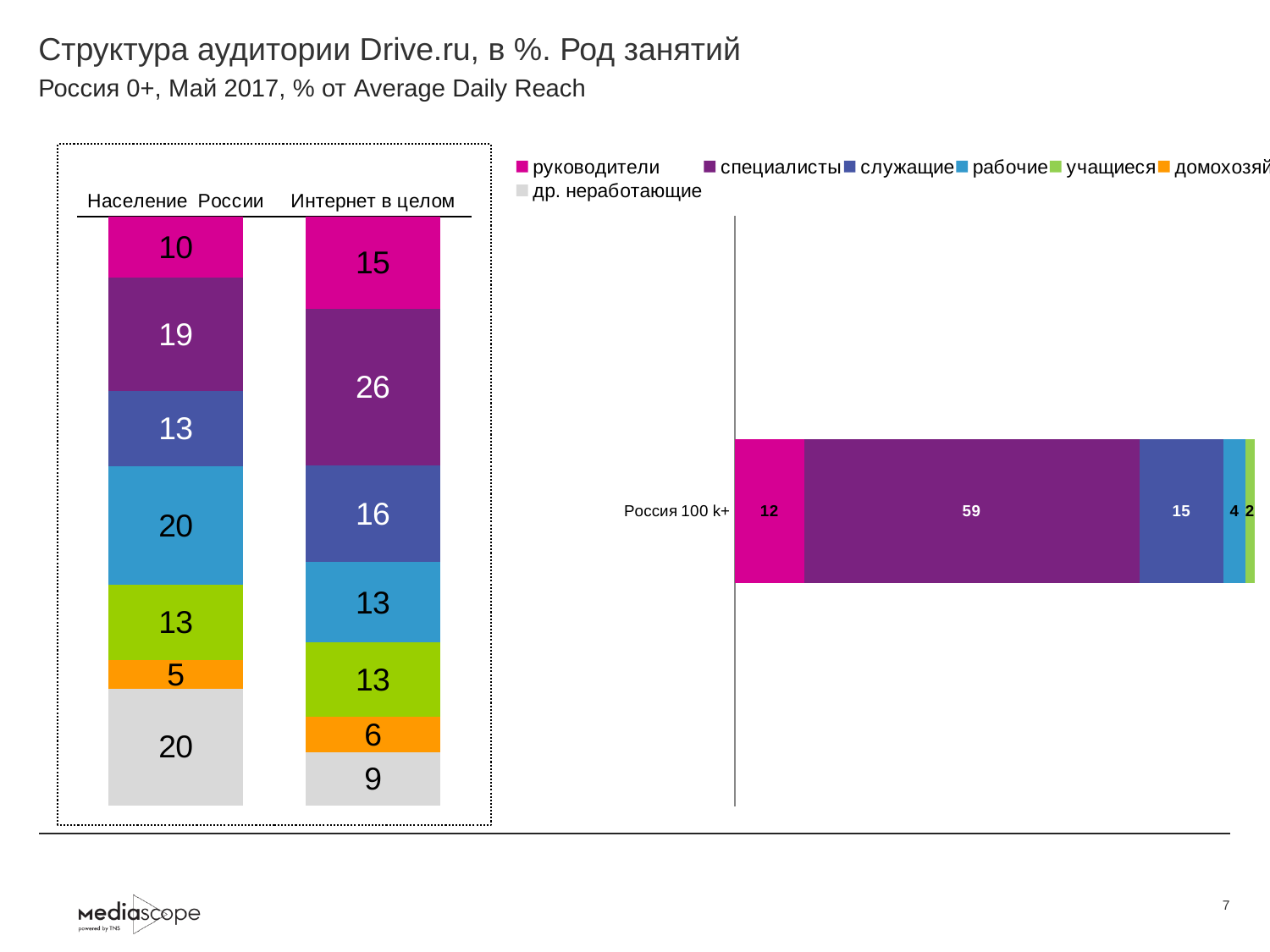
How many bars (categories) does the left chart show? 2 In the right chart (Россия 100 k+), what is the value for руководители? 12 In the left chart, which segment is the largest in the Интернет в целом bar? специалисты What type of chart is shown on the left of the slide? bar chart In the right chart (Россия 100 k+), what is the value for специалисты? 59 In the left chart, what is the value for специалисты in the Население России bar? 19 In the left chart, which bar has the larger value for рабочие: Население России or Интернет в целом? Население России In the left chart, which segment is the smallest in the Население России bar? домохозяйки In the left chart, what is the value for руководители in the Интернет в целом bar? 15 In the left chart, what is the difference between the специалисты values for Интернет в целом and Население России? 7 In the left chart, what is the total of the Население России stacked bar? 100 In the right chart (Россия 100 k+), what is the value for служащие? 15